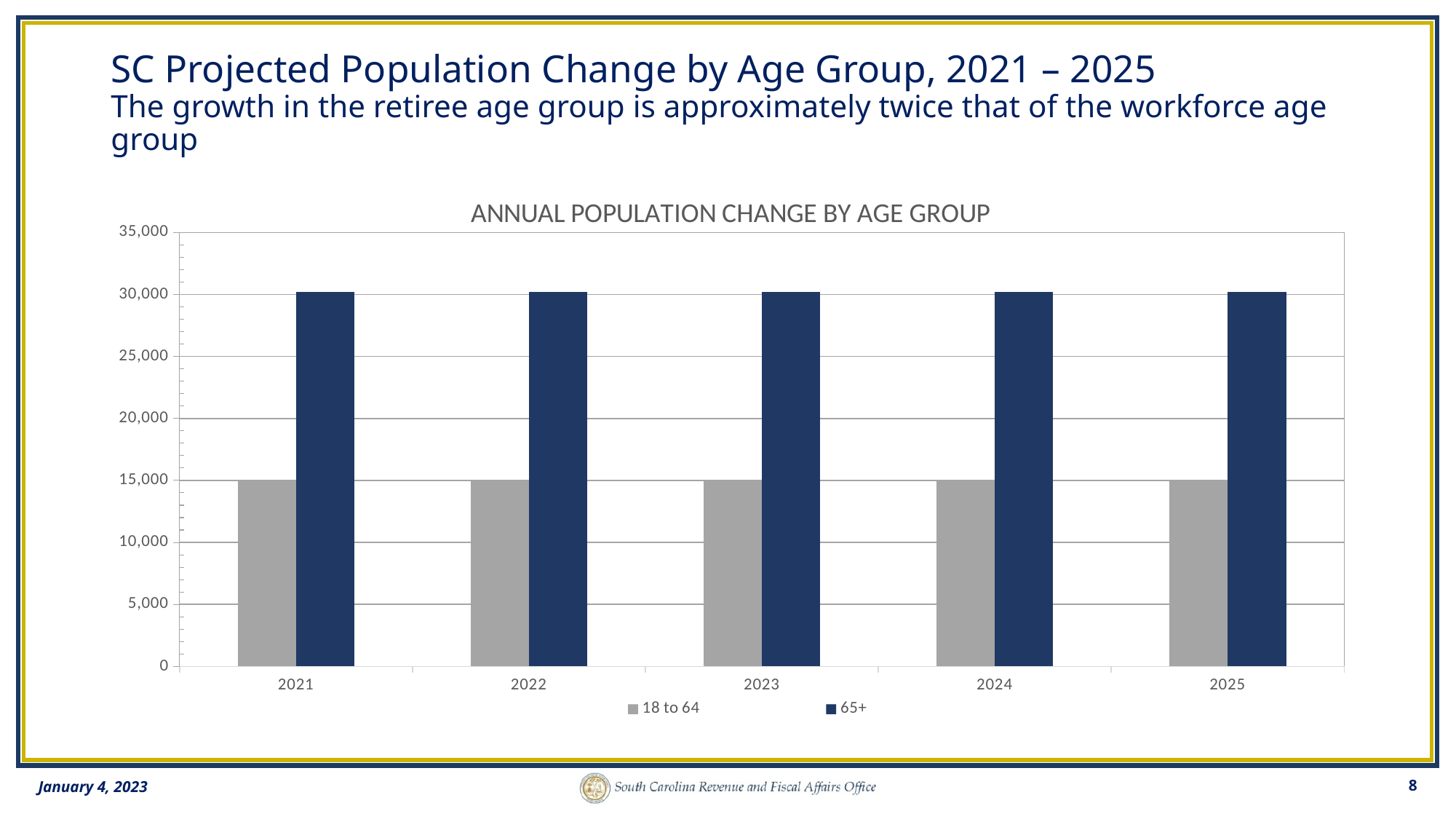
What kind of chart is shown on the slide? bar chart Do the values for the 65+ series rise, fall, or stay roughly flat from 2021 to 2025? stay roughly flat Which series has the lower values across all years? 18 to 64 Is the value for 18 to 64 in 2024 greater or less than 20,000? less Is the value for 65+ in 2025 greater or less than 35,000? less What is the title of the chart? ANNUAL POPULATION CHANGE BY AGE GROUP Is the value for 65+ in 2021 greater or less than 25,000? greater Which age group has the larger projected population change in 2023? 65+ How many series does the legend list? 2 Which series is shown in dark blue? 65+ How many years are shown on the x axis? 5